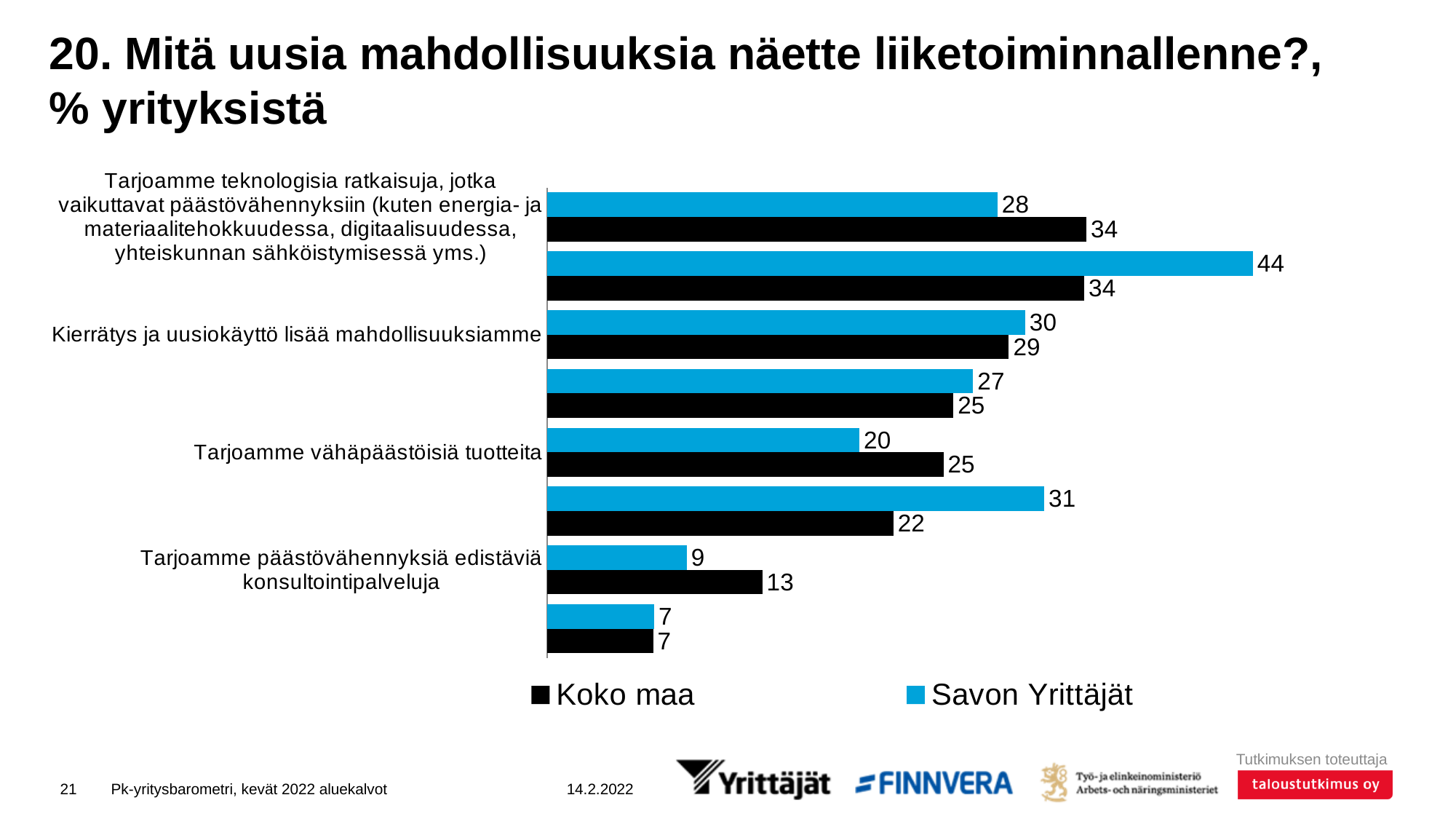
What is the Koko maa value for 'Tarjoamme päästövähennyksiä edistäviä konsultointipalveluja'? 13 What is the lowest value shown for the Koko maa series? 7 What is the highest value shown for the Savon Yrittäjät series? 44 What is the difference between the Koko maa and Savon Yrittäjät values for 'Tarjoamme vähäpäästöisiä tuotteita'? 5 What is the Koko maa value for 'Tarjoamme teknologisia ratkaisuja, jotka vaikuttavat päästövähennyksiin'? 34 What is the Savon Yrittäjät value for 'Kierrätys ja uusiokäyttö lisää mahdollisuuksiamme'? 30 What is the Koko maa value for 'Kierrätys ja uusiokäyttö lisää mahdollisuuksiamme'? 29 For 'Tarjoamme päästövähennyksiä edistäviä konsultointipalveluja', which series has the larger value, Koko maa or Savon Yrittäjät? Koko maa How many series does the legend list? 2 What are the two series named in the legend? Koko maa and Savon Yrittäjät What kind of chart is shown on the slide? bar chart What is the Savon Yrittäjät value for 'Tarjoamme vähäpäästöisiä tuotteita'? 20